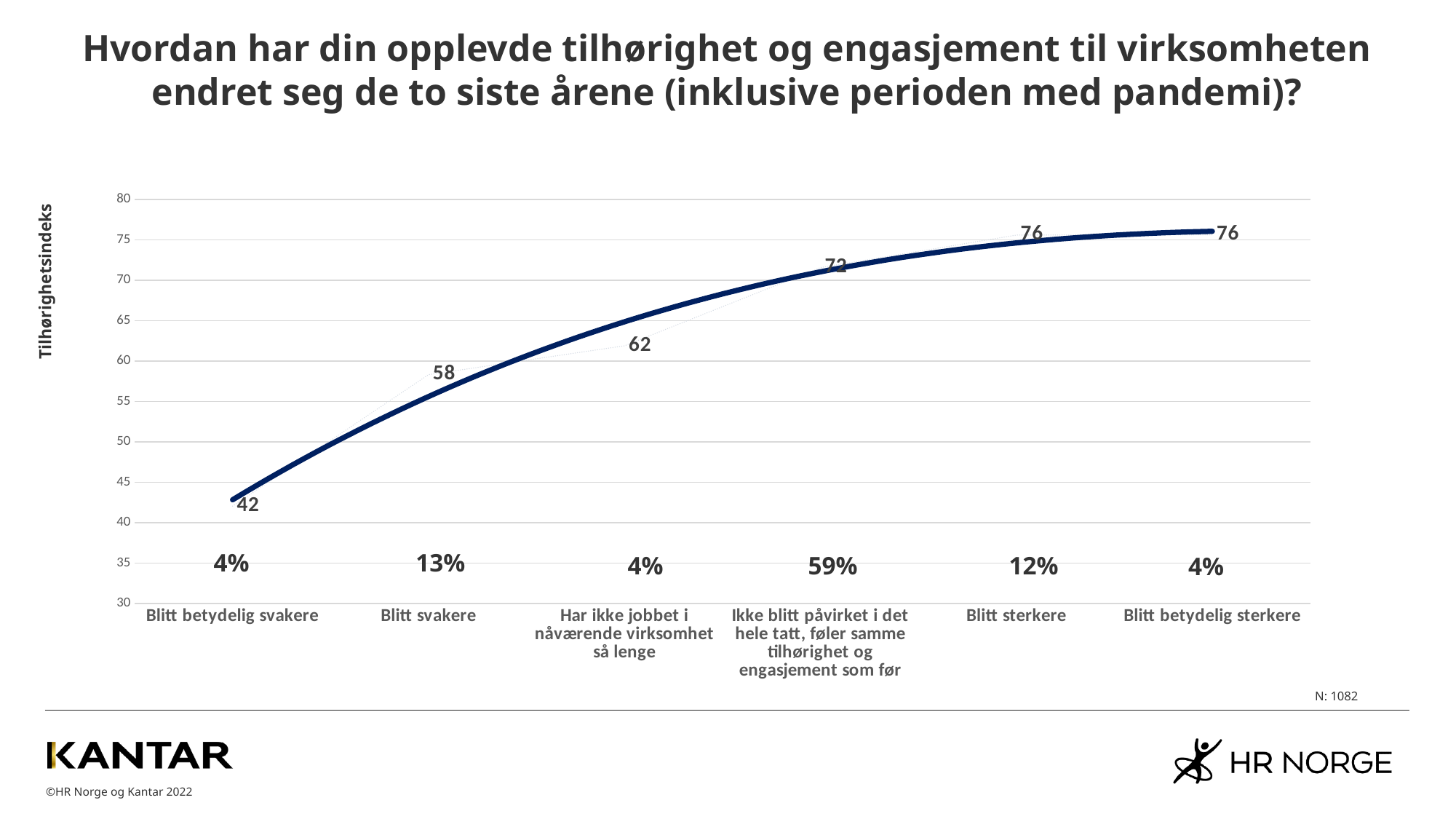
What is the difference in Tilhørighetsindeks between "Blitt sterkere" and "Blitt betydelig svakere"? 34 What kind of chart is shown on the slide? Line chart Which category has the lowest Tilhørighetsindeks value? Blitt betydelig svakere How many categories are shown on the x axis of the chart? 6 What is the label of the vertical axis of the chart? Tilhørighetsindeks Which has a higher Tilhørighetsindeks value, "Blitt svakere" or "Har ikke jobbet i nåværende virksomhet så lenge"? Har ikke jobbet i nåværende virksomhet så lenge What percentage of respondents is shown for "Ikke blitt påvirket i det hele tatt, føler samme tilhørighet og engasjement som før"? 59% Do the Tilhørighetsindeks values rise or fall from left to right along the x axis? Rise What is the Tilhørighetsindeks value for "Ikke blitt påvirket i det hele tatt, føler samme tilhørighet og engasjement som før"? 72 What percentage of respondents is shown for "Blitt svakere"? 13% What is the Tilhørighetsindeks value for "Blitt betydelig svakere"? 42 What is the Tilhørighetsindeks value for "Blitt svakere"? 58